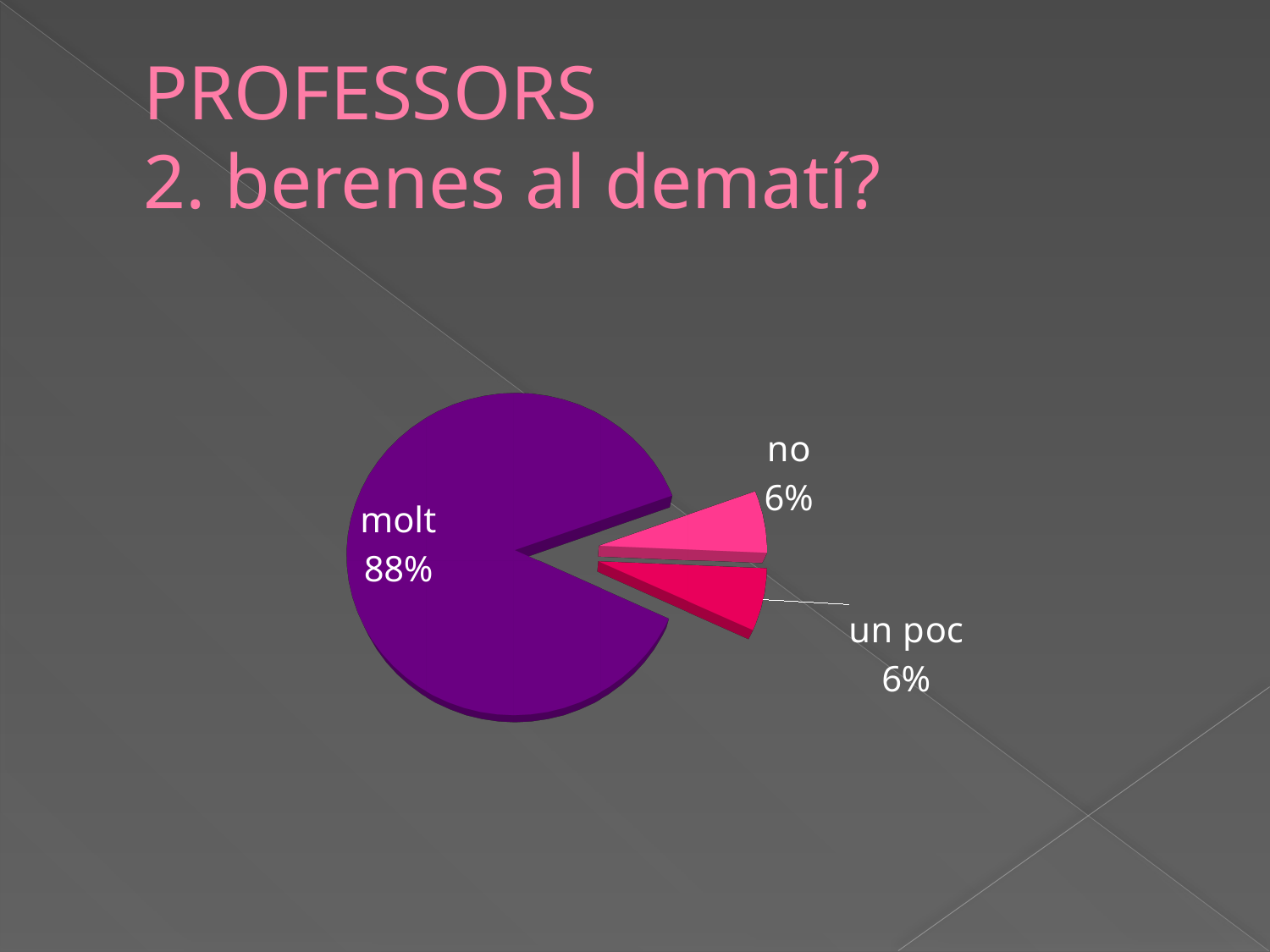
Is the share for "molt" greater or less than 50%? greater What kind of chart is shown on the slide? pie chart Which category has the largest slice of the pie? molt How many slices does the pie chart have? 3 What is the difference in percentage points between the "molt" slice and the "no" slice? 82 What question does the slide title pose about the chart? 2. berenes al dematí? What is the combined share of the "no" and "un poc" slices? 12% What share of the pie does the "molt" slice represent? 88% What share of the pie does the "un poc" slice represent? 6% What share of the pie does the "no" slice represent? 6% What colour is the "molt" slice? purple Which is larger, the "molt" slice or the "un poc" slice? molt